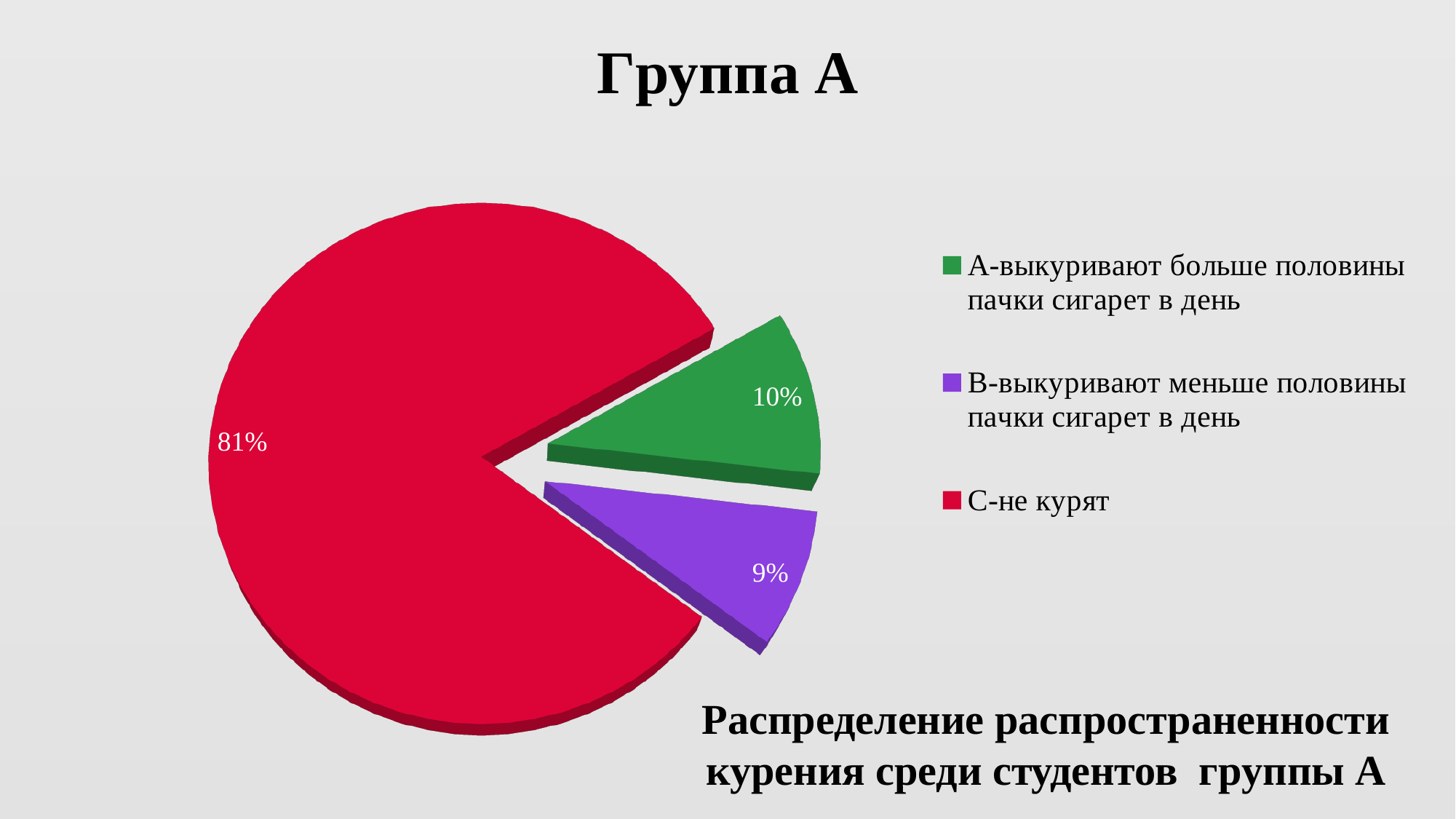
What colour is the slice for "C-не курят"? Red What is the difference in percentage points between the "A" slice (10%) and the "B" slice (9%)? 1 What share of the pie is labelled "B-выкуривают меньше половины пачки сигарет в день"? 9% How many entries does the legend list? 3 Which category has the largest slice of the pie? C-не курят What is the title shown above the chart? Группа А What share of the pie is labelled "C-не курят"? 81% What kind of chart is shown on the slide? Pie chart What share of the pie is labelled "A-выкуривают больше половины пачки сигарет в день"? 10% How many slices does the pie chart have? 3 What is the difference in percentage points between the "C-не курят" slice and the "A-выкуривают больше половины пачки сигарет в день" slice? 71 Which category has the smallest slice of the pie? B-выкуривают меньше половины пачки сигарет в день